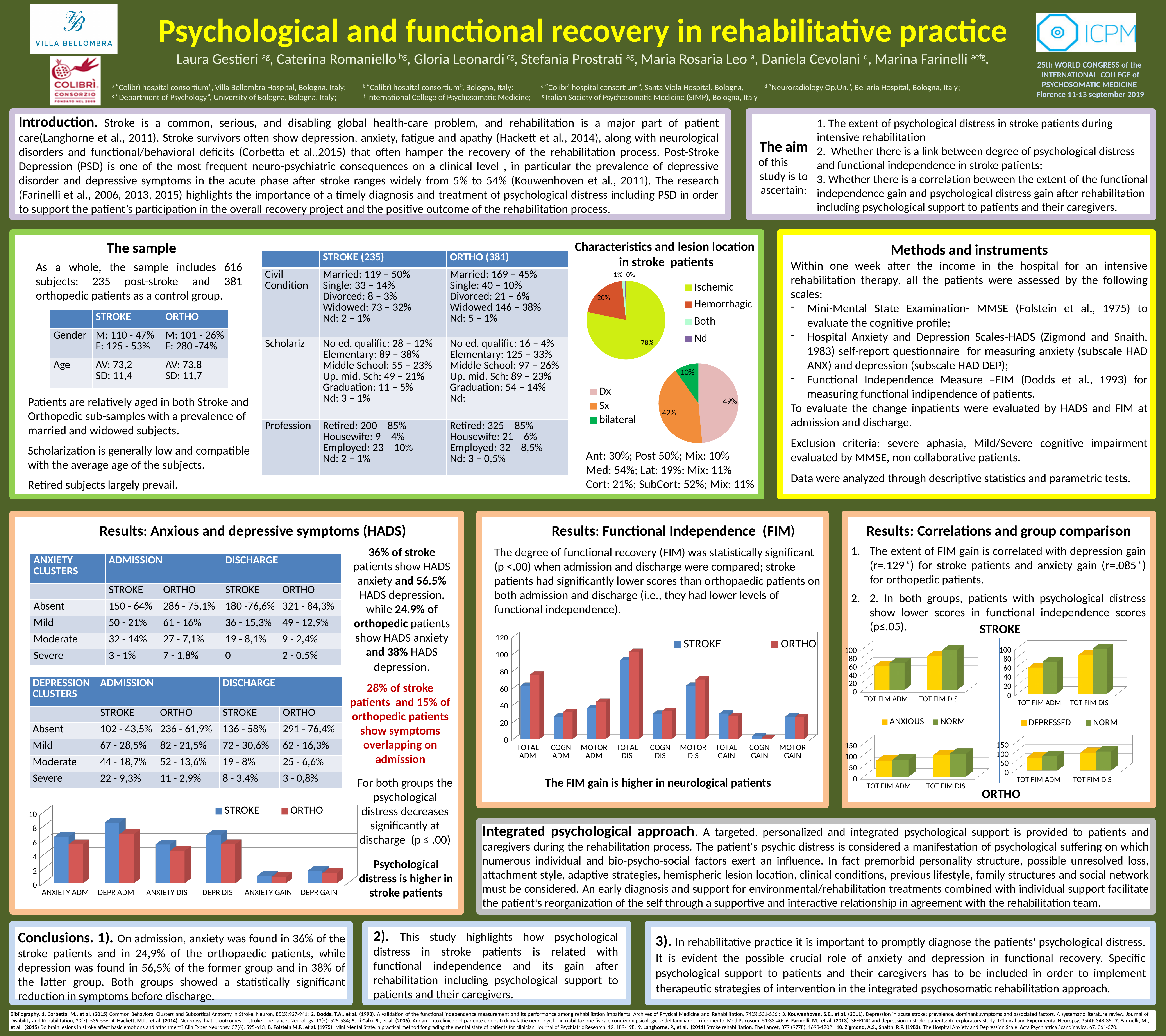
In the lower pie chart under 'Characteristics and lesion location in stroke patients', what is the difference in percentage points between Dx and Sx? 7 In the lower pie chart under 'Characteristics and lesion location in stroke patients', which category has the smallest slice? bilateral In the bar chart in the 'Results: Functional Independence (FIM)' section, which series has the larger value for TOTAL ADM, STROKE or ORTHO? ORTHO In the upper pie chart under 'Characteristics and lesion location in stroke patients', what percentage is Hemorrhagic? 20% In the upper pie chart under 'Characteristics and lesion location in stroke patients', how many categories does the legend list? 4 In the upper pie chart under 'Characteristics and lesion location in stroke patients', which category has the largest slice? Ischemic In the bar chart in the 'Results: Anxious and depressive symptoms (HADS)' section, is the STROKE value for DEPR ADM greater or less than 8? greater In the bar chart in the 'Results: Anxious and depressive symptoms (HADS)' section, how many categories are on the x axis? 6 In the upper pie chart under 'Characteristics and lesion location in stroke patients', what percentage of stroke patients are Ischemic? 78% In the lower pie chart under 'Characteristics and lesion location in stroke patients', what percentage is Dx? 49% What kind of chart is shown in the 'Results: Anxious and depressive symptoms (HADS)' section? bar chart In the bar chart in the 'Results: Functional Independence (FIM)' section, how many series does the legend list? 2